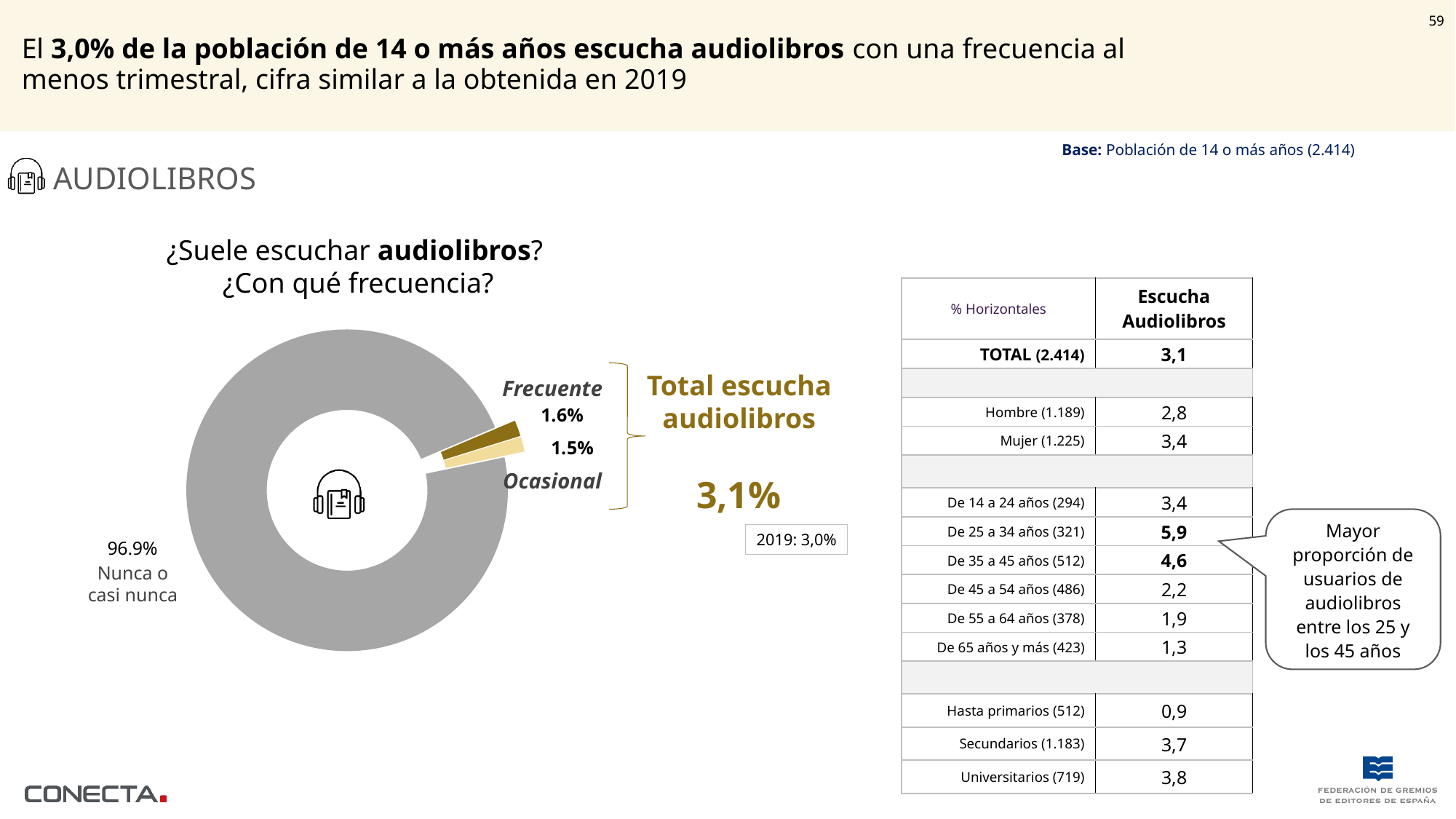
Which slice of the donut chart is the smallest? Ocasional How many slices does the donut chart have? 3 What kind of chart is used to show how often people listen to audiobooks? Pie chart (donut) In the donut chart, what percentage is shown for "Ocasional"? 1.5% Which slice of the donut chart is the largest? Nunca o casi nunca In the donut chart, what percentage is shown for "Nunca o casi nunca"? 96.9% What value for 2019 is shown next to the donut chart? 3,0% In the donut chart, which is larger: "Frecuente" or "Ocasional"? Frecuente In the donut chart, what is the difference between the "Frecuente" and "Ocasional" percentages? 0.1% In the donut chart, what percentage is shown for "Frecuente"? 1.6% What is the title of the donut chart? ¿Suele escuchar audiolibros? ¿Con qué frecuencia? What is the combined share of "Frecuente" and "Ocasional" shown as "Total escucha audiolibros"? 3,1%